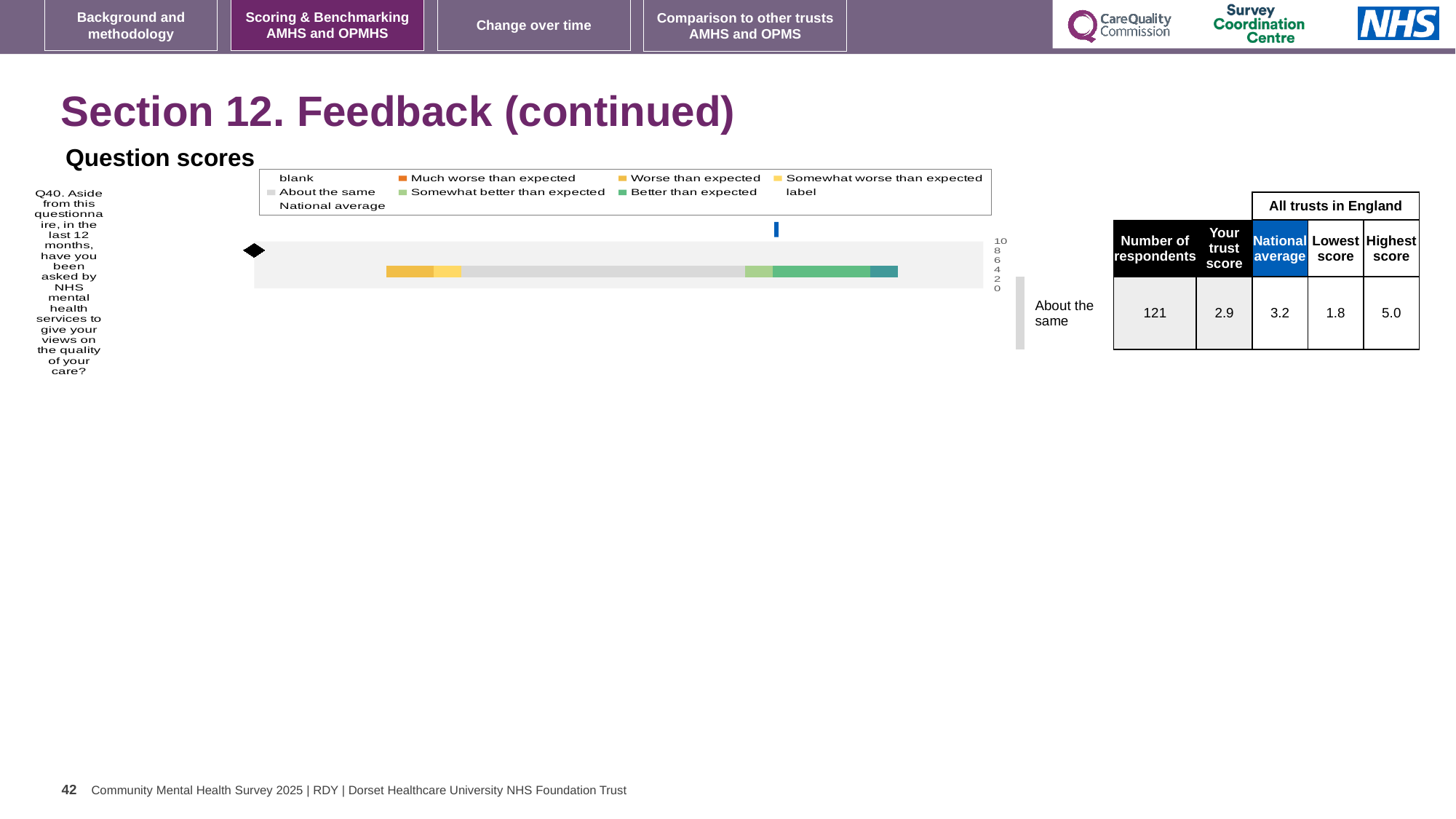
In the table next to the Question scores chart, what is the highest score among all trusts in England for Q40? 5.0 Which question number is plotted in the Question scores chart? Q40 What category label is shown to the right of the Q40 bar in the Question scores chart? About the same In the table next to the Question scores chart, what is the difference between the highest score and the lowest score for Q40? 3.2 What kind of chart is shown under 'Question scores'? bar chart In the table next to the Question scores chart, what is the number of respondents for Q40? 121 In the table next to the Question scores chart, which is larger for Q40: your trust score or the national average? National average In the table next to the Question scores chart, what is the lowest score among all trusts in England for Q40? 1.8 In the table next to the Question scores chart, what is the national average for Q40? 3.2 How many questions (categories) are plotted in the Question scores chart? 1 In the table next to the Question scores chart, what is your trust score for Q40? 2.9 In the table next to the Question scores chart, what is the difference between the national average and your trust score for Q40? 0.3